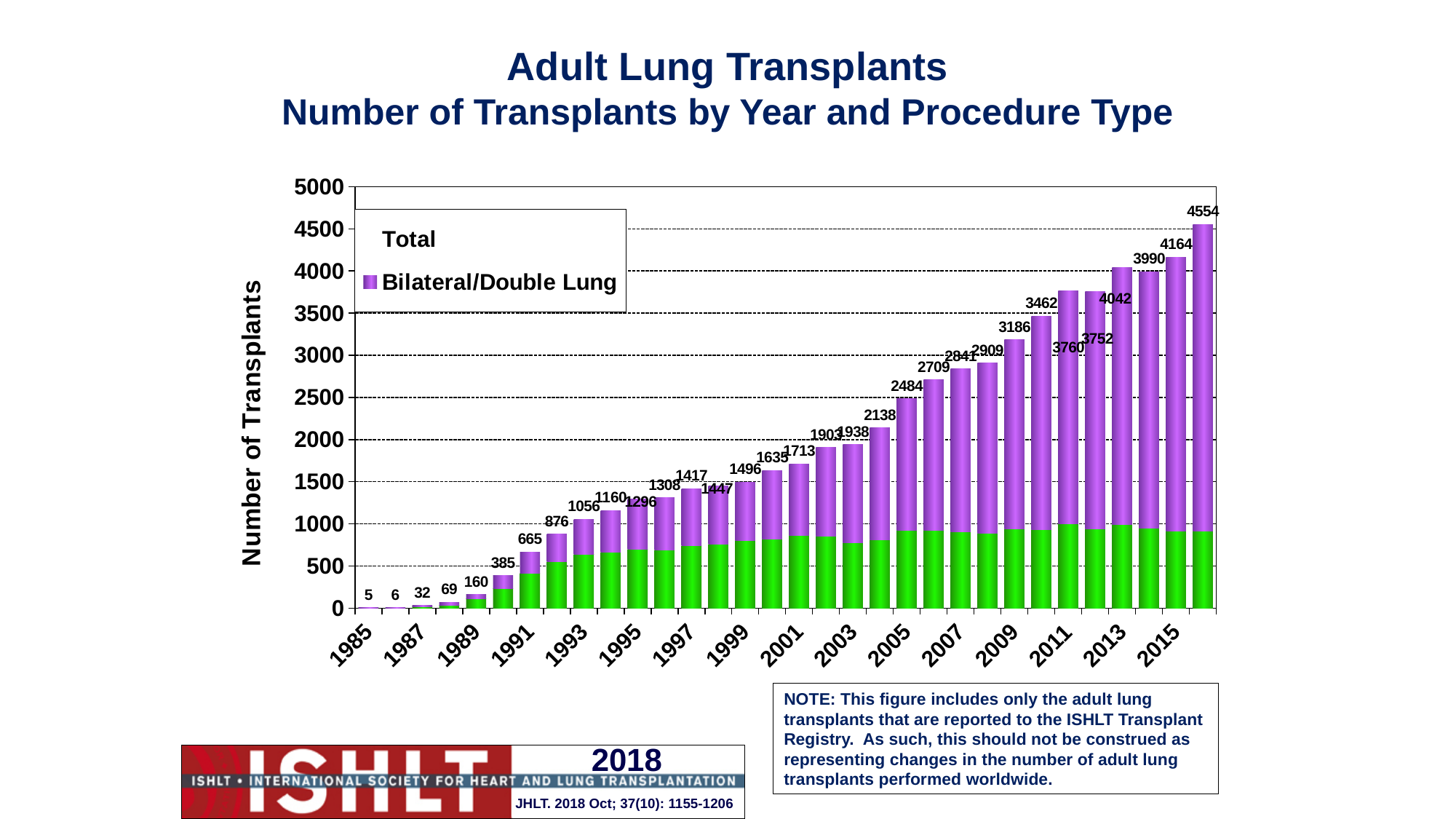
What is the label on the vertical axis of the chart? Number of Transplants Which year has the lowest total number of transplants? 1985 What kind of chart is shown on the slide? Stacked bar chart Is the green (lower) portion of the 2016 bar greater or less than 1000? less What is the total number of adult lung transplants shown for 2016? 4554 What is the total number of transplants labelled for 1990? 385 By how much did the total number of transplants increase from 2015 to 2016? 390 Do the total numbers of transplants generally rise or fall from 1985 to 2016? Rise What is the total number of adult lung transplants shown for 1985? 5 Which year has the highest total number of transplants? 2016 Which year had a larger total number of transplants, 2013 or 2014? 2013 What is the total number of transplants labelled for 2005? 2484